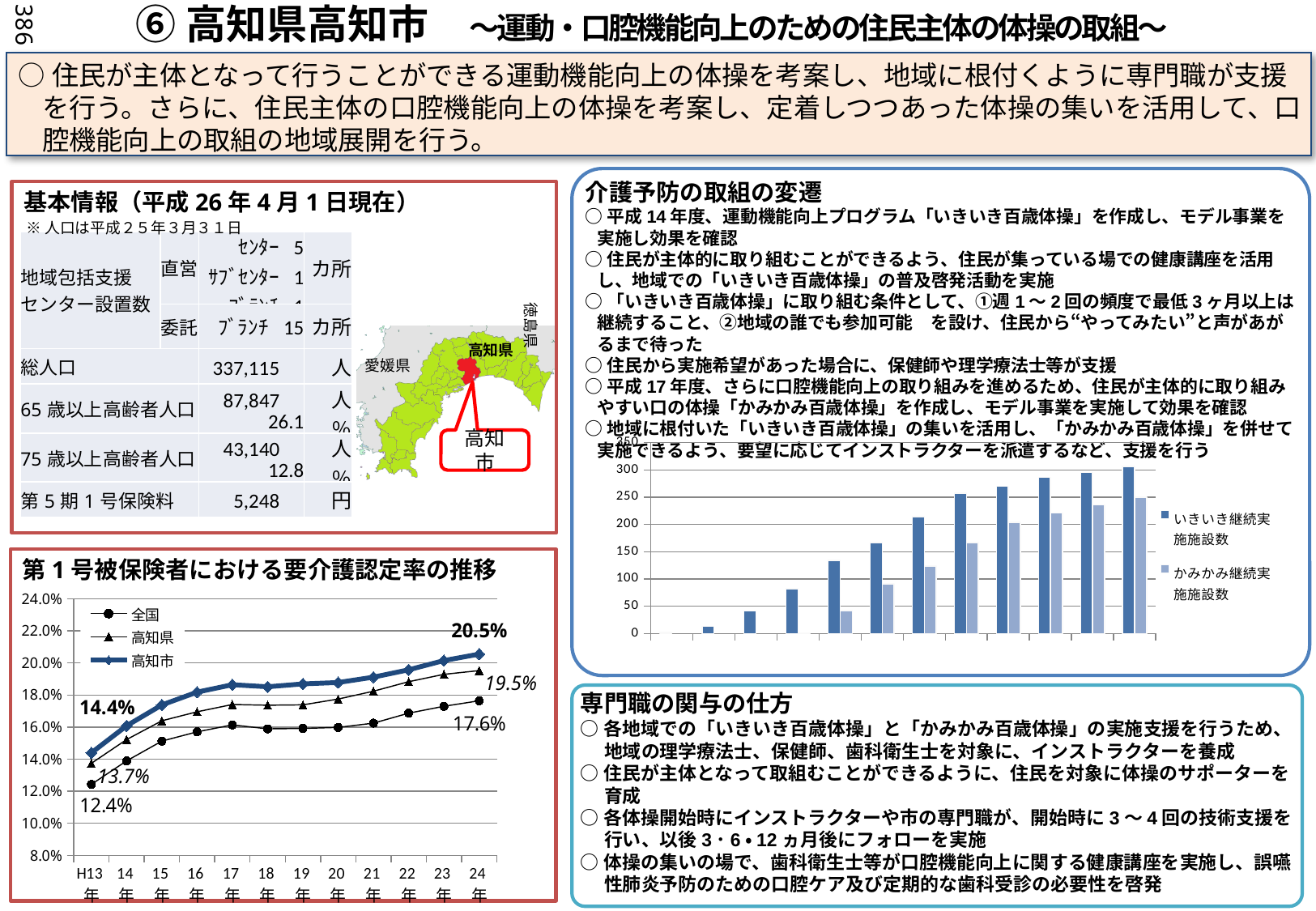
In the chart titled 第1号被保険者における要介護認定率の推移, what is the value for 高知市 in 24年? 20.5% In the chart titled 第1号被保険者における要介護認定率の推移, do the 高知市 values generally rise or fall from H13年 to 24年? rise In the chart titled 第1号被保険者における要介護認定率の推移, what is the value for 高知県 in 24年? 19.5% In the chart titled 第1号被保険者における要介護認定率の推移, which series has the lowest value in H13年? 全国 What kind of chart is the chart on the right side of the slide showing いきいき継続実施施設数 and かみかみ継続実施施設数? bar chart In the chart titled 第1号被保険者における要介護認定率の推移, what is the value for 高知市 in H13年? 14.4% In the chart titled 第1号被保険者における要介護認定率の推移, what is the value for 全国 in 24年? 17.6% In the chart titled 第1号被保険者における要介護認定率の推移, what is the value for 全国 in H13年? 12.4% In the bar chart on the right side of the slide, how many series does the legend list? 2 In the chart titled 第1号被保険者における要介護認定率の推移, how many series does the legend list? 3 In the chart titled 第1号被保険者における要介護認定率の推移, what is the difference between the 高知市 values in 24年 and H13年? 6.1% In the chart titled 第1号被保険者における要介護認定率の推移, which series has the highest value in 24年? 高知市